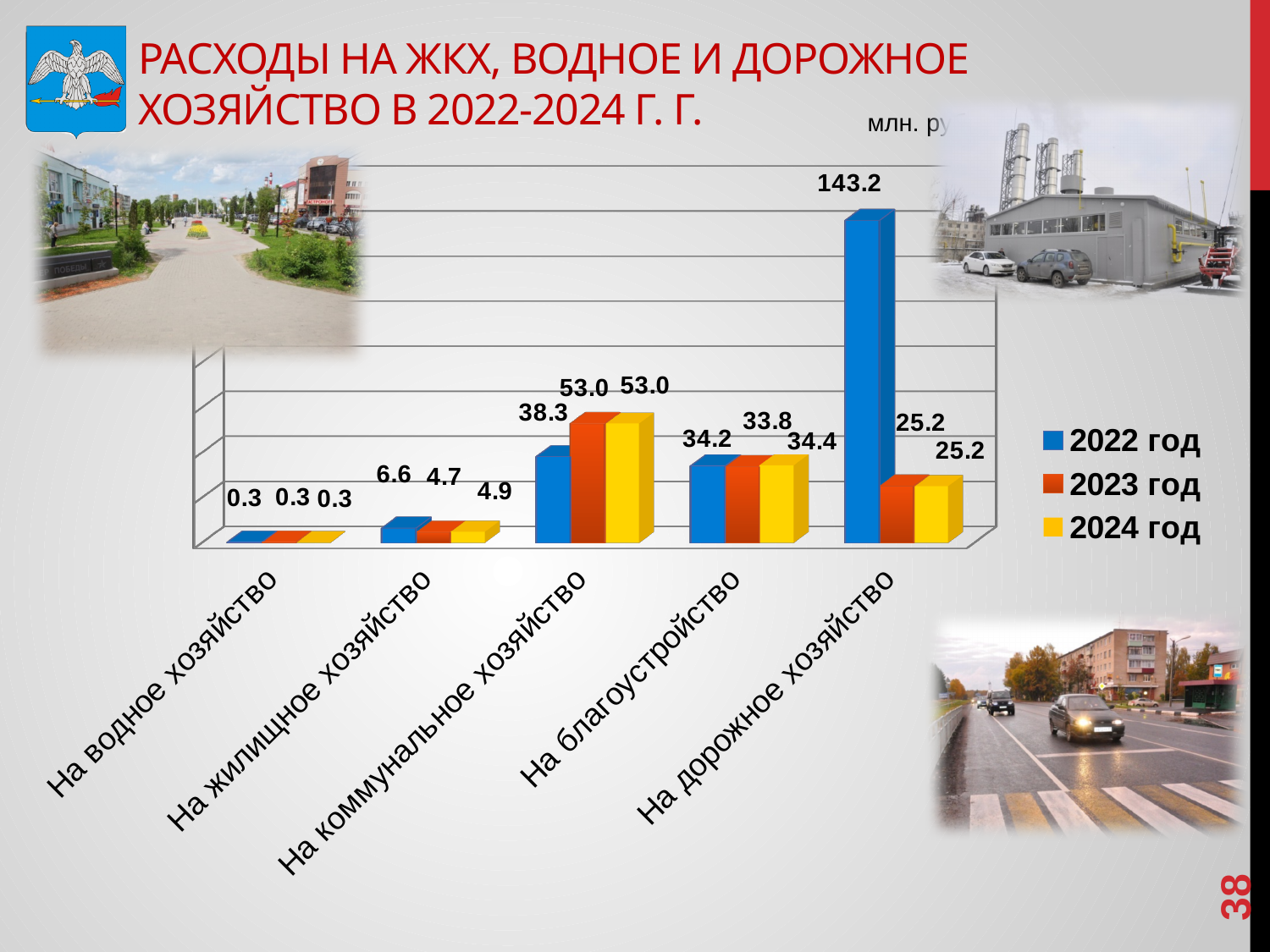
Which category has the lowest value in the 2023 год series? На водное хозяйство What is the value for На коммунальное хозяйство in the 2023 год series? 53.0 Which is larger for На коммунальное хозяйство: the 2022 год value or the 2024 год value? 2024 год How many series does the legend list? 3 How many categories are shown on the x axis? 5 What is the value for На дорожное хозяйство in the 2022 год series? 143.2 What is the value for На благоустройство in the 2022 год series? 34.2 What colour represents the 2023 год series in the legend? Orange What kind of chart is shown on the slide? Bar chart Which category has the highest value in the 2022 год series? На дорожное хозяйство What is the difference between the 2022 год and 2023 год values for На дорожное хозяйство? 118.0 What is the value for На жилищное хозяйство in the 2024 год series? 4.9